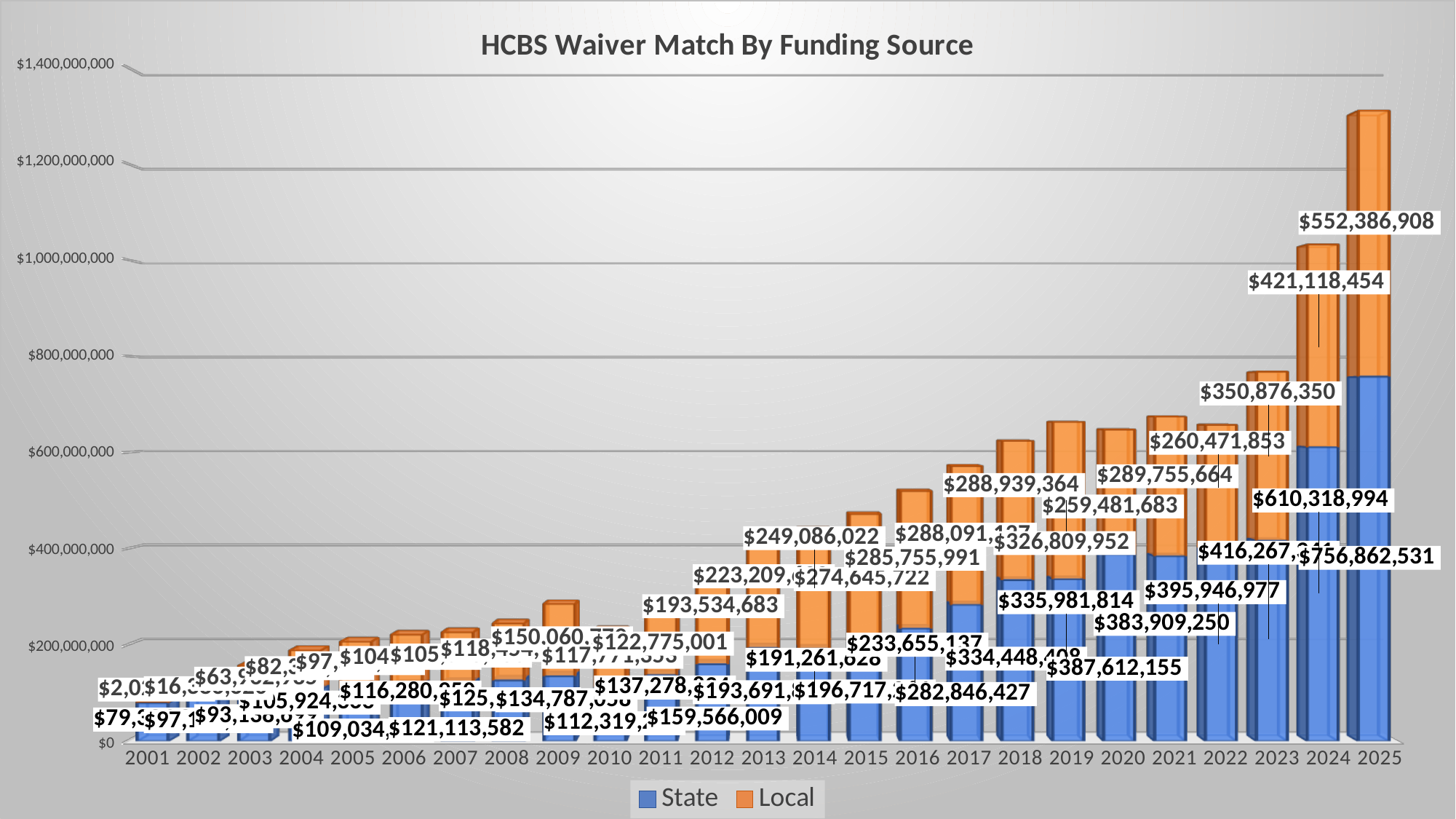
How many years are shown along the x axis? 25 What is the Local value for 2023? $350,876,350 Is the total for 2019 greater or less than $600,000,000? greater What is the State value for 2025? $756,862,531 Which year has the lowest total HCBS Waiver Match? 2001 What is the Local value for 2025? $552,386,908 Which year has the highest total HCBS Waiver Match? 2025 What is the State value for 2024? $610,318,994 How many series does the legend list? 2 What is the total HCBS Waiver Match for 2025 (State plus Local)? $1,309,249,439 What kind of chart is shown on the slide? Stacked bar chart How much larger is the State value than the Local value in 2025? $204,475,623